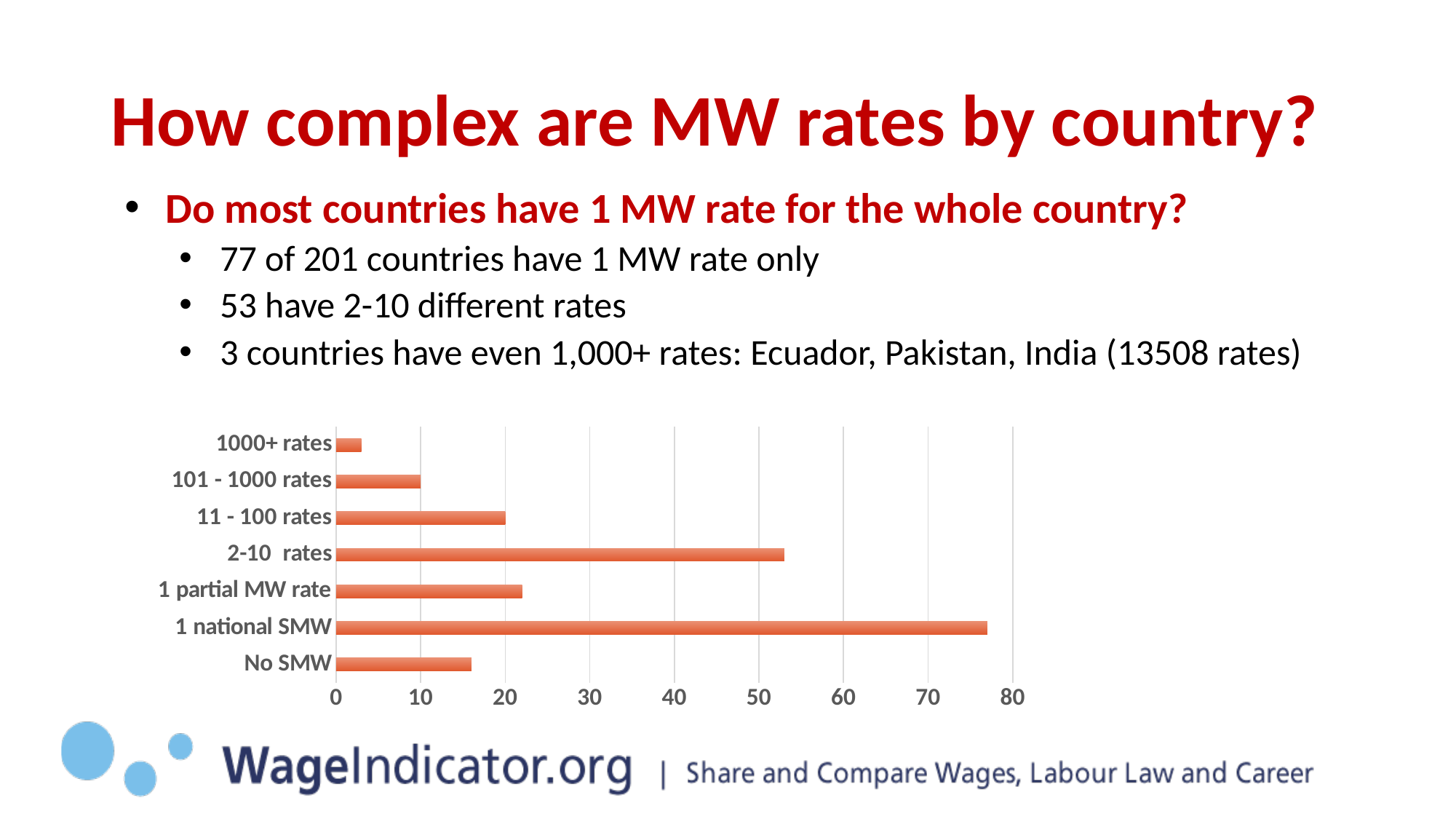
Is the value for No SMW greater or less than 20? less How many categories does the bar chart show? 7 Which is larger, the value for 2-10 rates or the value for 1 partial MW rate? 2-10 rates What is the value for 2-10 rates? 53 What is the value for 101 - 1000 rates? 10 Which category has the highest value in the bar chart? 1 national SMW Which category has the lowest value in the bar chart? 1000+ rates What is the value for 1 national SMW? 77 What kind of chart is shown on the slide? bar chart Is the value for 1 partial MW rate greater or less than 20? greater What is the value for 11 - 100 rates? 20 What is the difference between the values for 1 national SMW and 2-10 rates? 24